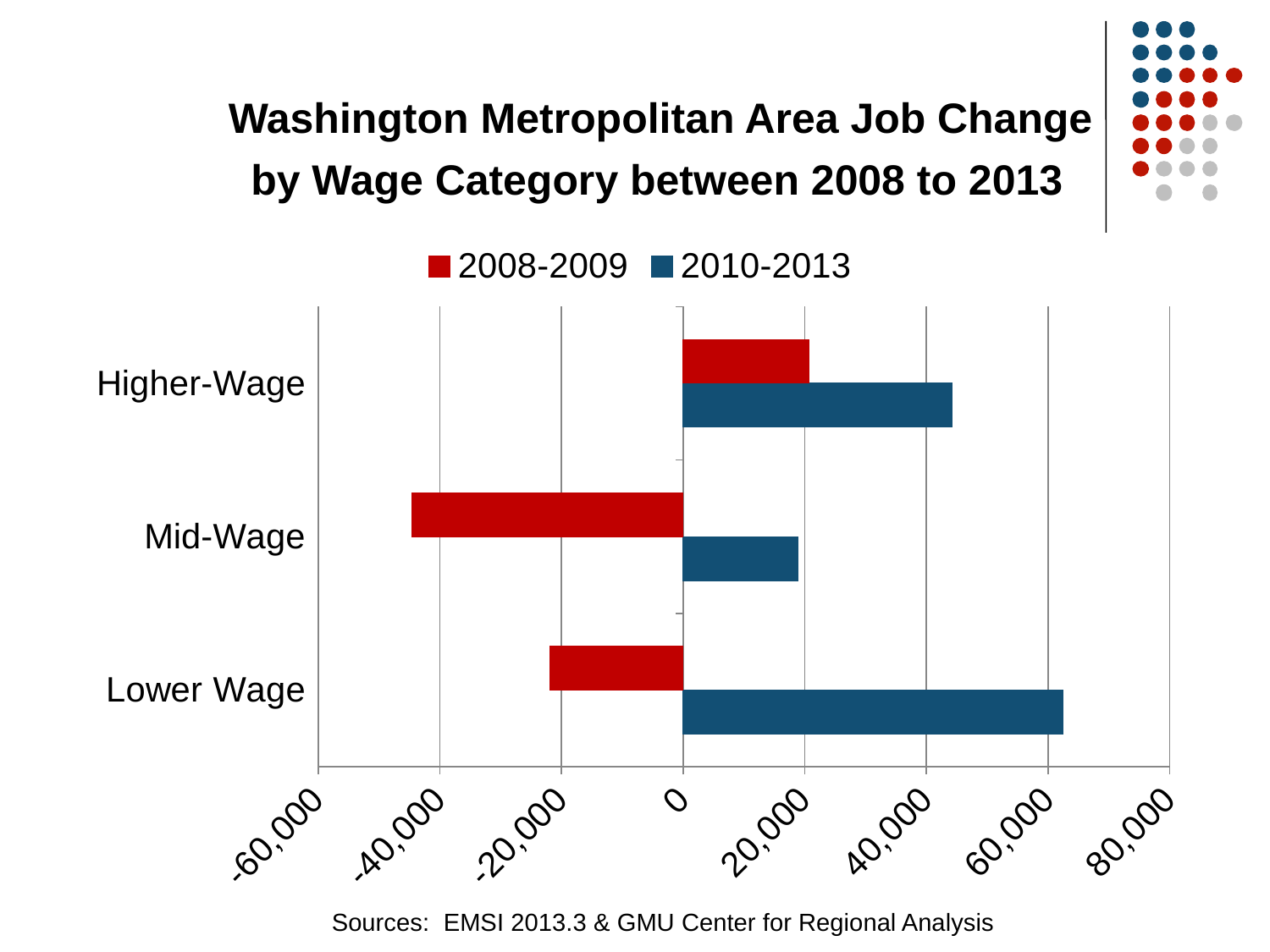
What kind of chart is shown on the slide? bar chart How many series does the legend list? 2 Which colour represents the 2008-2009 series in the legend? red Which wage category has the lowest value for 2010-2013? Mid-Wage Is the 2008-2009 value for Mid-Wage greater or less than -40,000? less Which wage category has the highest value for 2010-2013? Lower Wage How many wage categories are shown on the chart? 3 Which wage category has the lowest value for 2008-2009? Mid-Wage Is the 2010-2013 value for Lower Wage greater or less than 40,000? greater For 2010-2013, which is larger: the value for Higher-Wage or the value for Mid-Wage? Higher-Wage Is the 2010-2013 value for Higher-Wage greater or less than 40,000? greater For 2008-2009, which is larger: the value for Lower Wage or the value for Mid-Wage? Lower Wage